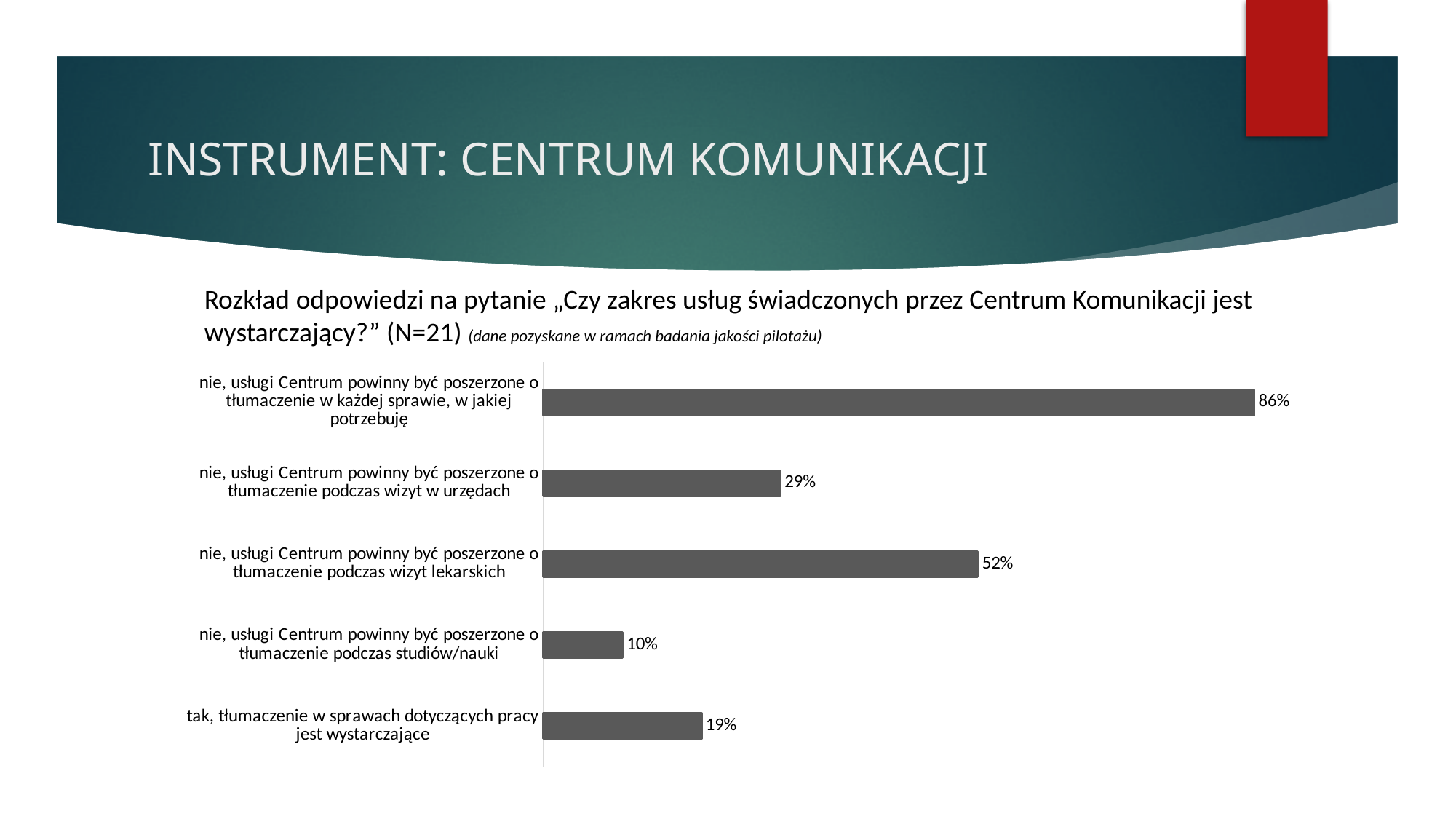
What is the difference in percentage points between the answer about translation in every matter (86%) and the answer about translation during medical visits (52%)? 34 percentage points How many respondents (N) does the chart title state? 21 What is the value for the answer about translation during studies ("podczas studiów/nauki")? 10% What percentage of respondents answered that Centrum services should be extended to translation in every matter they need ("tłumaczenie w każdej sprawie, w jakiej potrzebuję")? 86% Which answer has the lowest percentage? nie, usługi Centrum powinny być poszerzone o tłumaczenie podczas studiów/nauki How many answer categories are shown in the chart? 5 Which answer has the highest percentage? nie, usługi Centrum powinny być poszerzone o tłumaczenie w każdej sprawie, w jakiej potrzebuję What is the value for the answer about extending services to translation during visits to offices ("podczas wizyt w urzędach")? 29% What type of chart is shown on the slide? bar chart Which is larger: the value for translation during visits to offices or the value for translation during medical visits? translation during medical visits (52%) What percentage answered "tak, tłumaczenie w sprawach dotyczących pracy jest wystarczające"? 19% What percentage chose the answer about translation during medical visits ("podczas wizyt lekarskich")? 52%